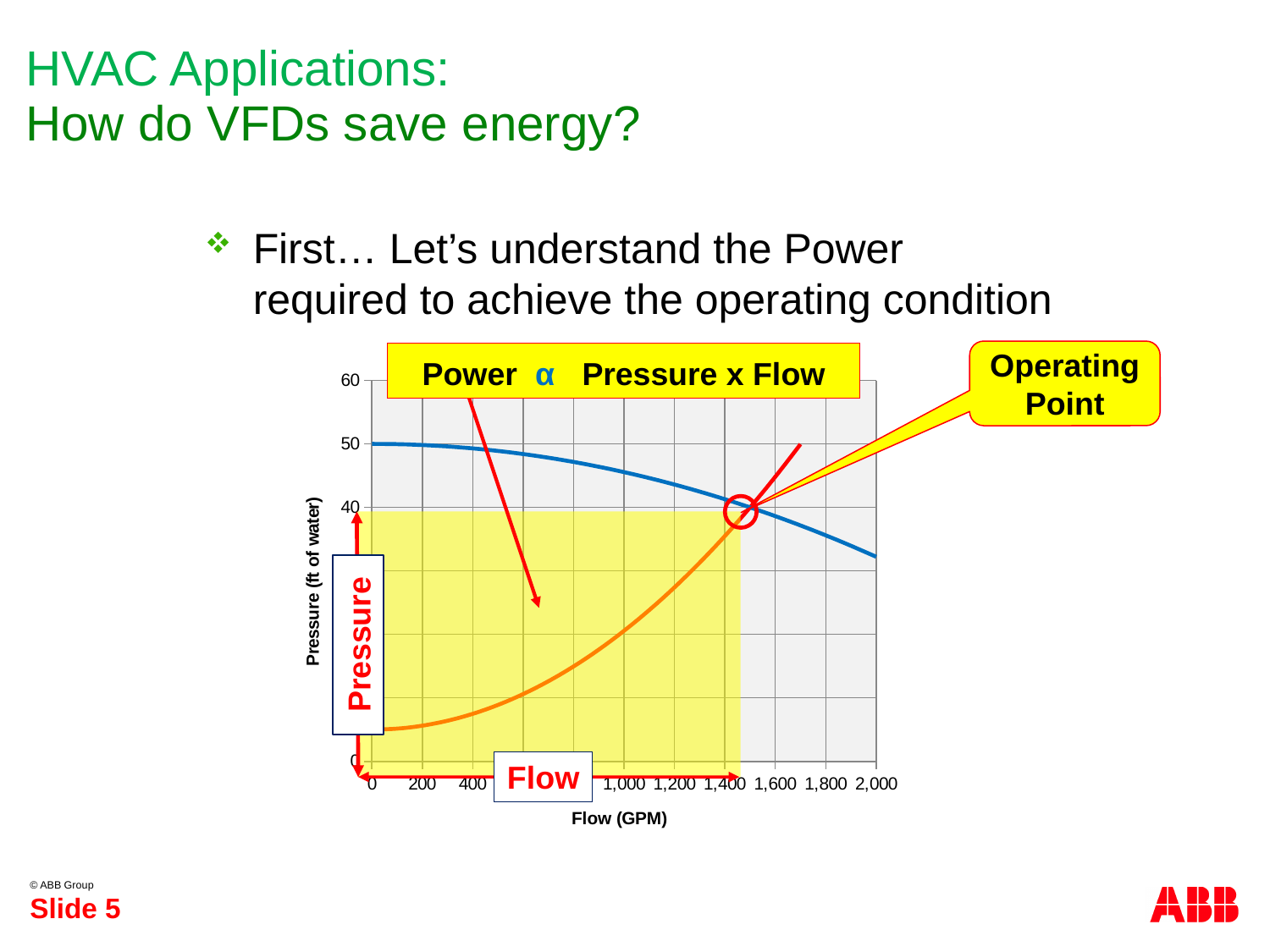
What is the highest value labelled on the flow axis? 2,000 Is the pressure of the orange curve at 1,000 GPM greater or less than 40? less At 400 GPM, which curve shows the higher pressure, the blue curve or the orange curve? The blue curve What is the title of the vertical axis of the chart? Pressure (ft of water) What kind of chart is shown on the slide? Line chart Does the orange curve rise or fall as flow increases along the x axis? Rise Does the blue curve rise or fall as flow increases along the x axis? Fall Is the pressure of the blue curve at 2,000 GPM greater or less than 40? less Is the pressure of the blue curve at 1,000 GPM greater or less than 40? greater What is the title of the horizontal axis of the chart? Flow (GPM) How many curves are plotted on the chart? 2